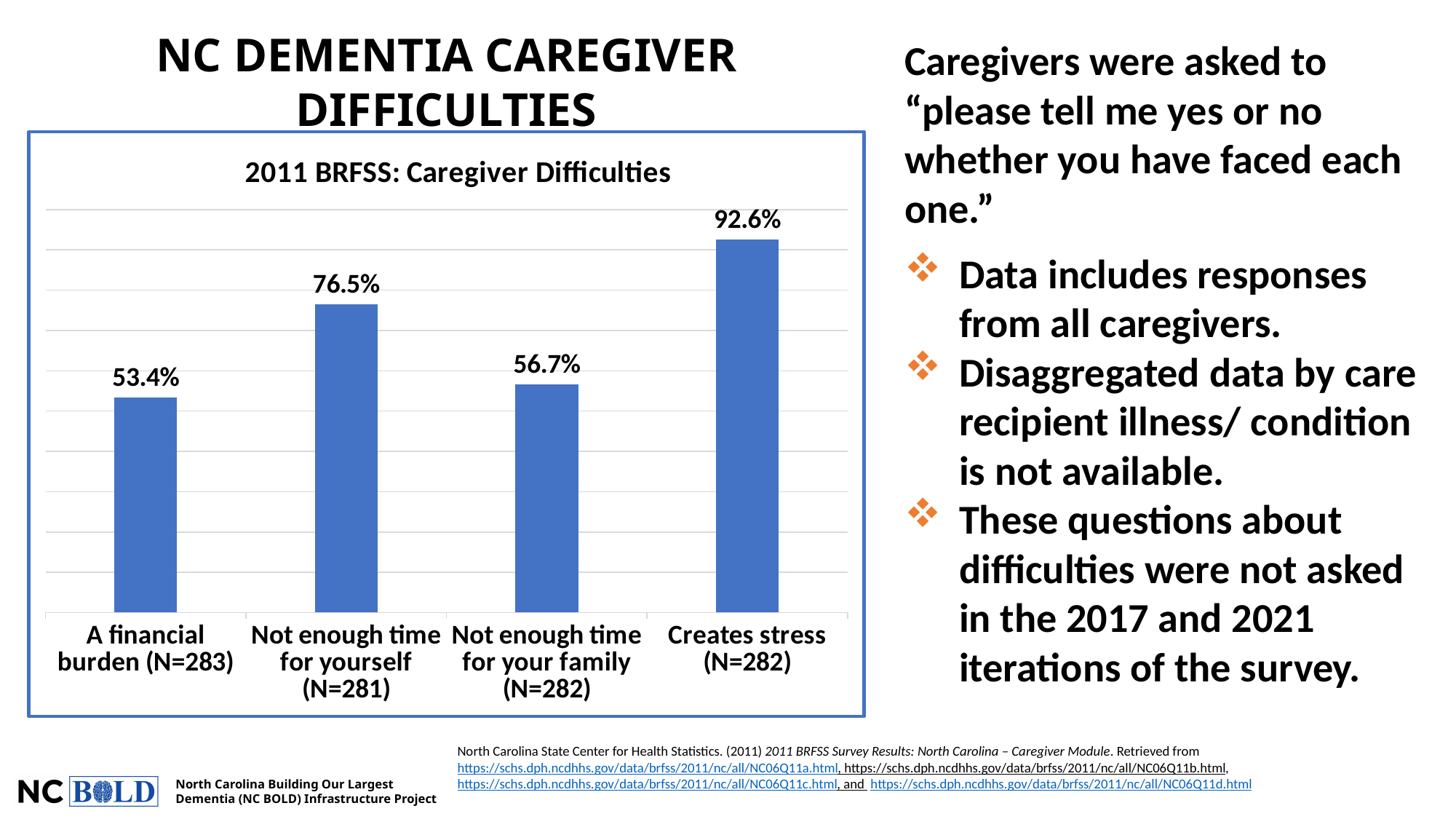
How many caregiver difficulty categories are shown in the chart? 4 Which caregiver difficulty has the lowest percentage? A financial burden (N=283) What is the difference between "Not enough time for yourself" and "Not enough time for your family"? 19.8% What is the difference between the percentage for "Creates stress" and the percentage for "A financial burden"? 39.2% Which caregiver difficulty has the highest percentage? Creates stress (N=282) What type of chart is used to show the caregiver difficulties? Bar chart What percentage of caregivers reported that caregiving creates stress? 92.6% What percentage of caregivers reported not enough time for yourself? 76.5% What is the title of the chart inside the blue border? 2011 BRFSS: Caregiver Difficulties What is the value for "Not enough time for your family (N=282)"? 56.7% What is the value for "A financial burden (N=283)"? 53.4% Which is larger: the value for "Not enough time for yourself" or the value for "Not enough time for your family"? Not enough time for yourself